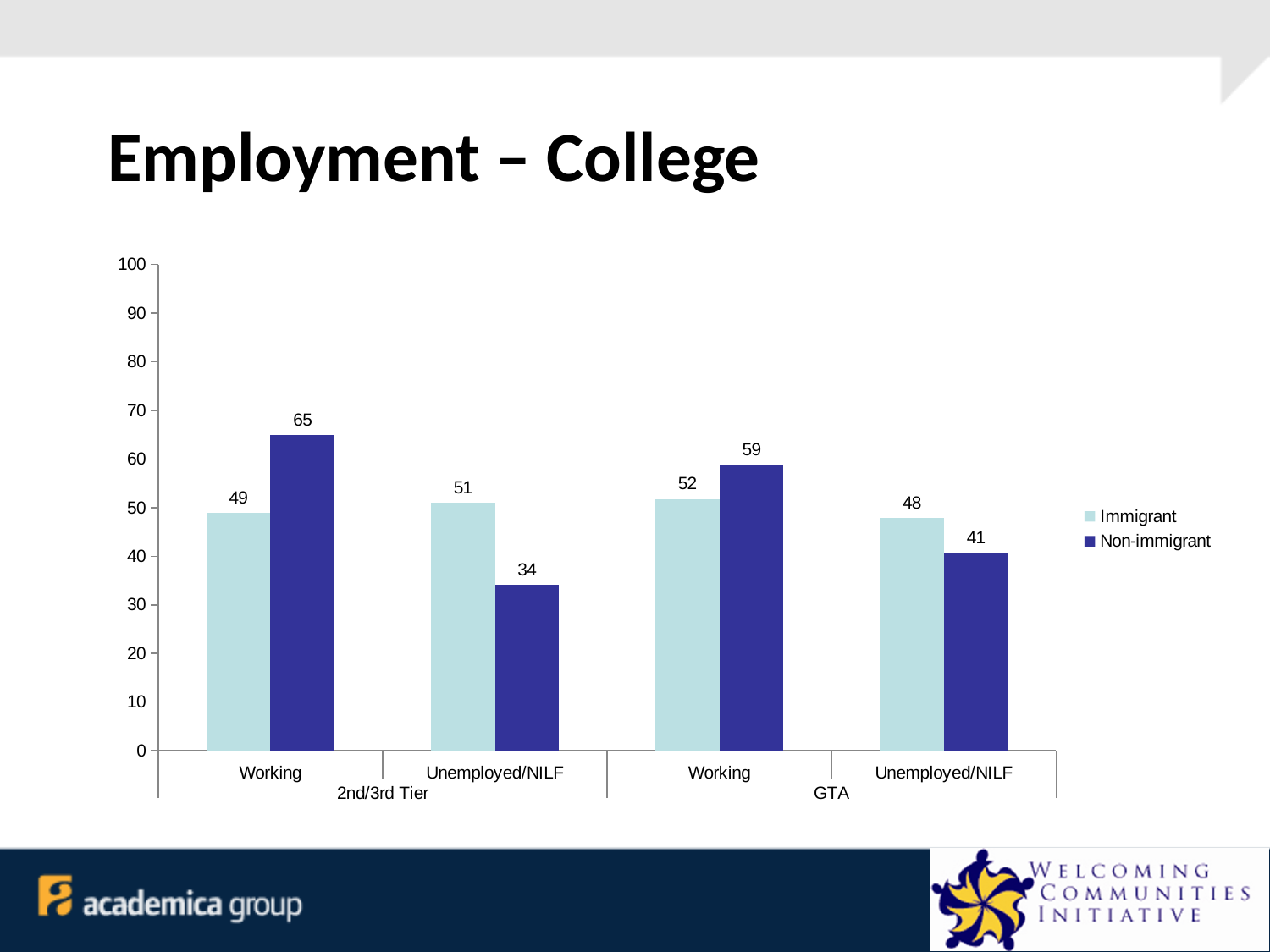
What is the Non-immigrant value for Unemployed/NILF in the 2nd/3rd Tier group? 34 Which category has the highest Non-immigrant value? Working (2nd/3rd Tier) Is the Non-immigrant value for Working in the GTA group greater or less than 50? greater What is the difference between the Immigrant and Non-immigrant values for Unemployed/NILF in the GTA group? 7 What is the difference between the Non-immigrant and Immigrant values for Working in the 2nd/3rd Tier group? 16 What is the Immigrant value for Unemployed/NILF in the GTA group? 48 What is the title of the slide? Employment – College What kind of chart is shown on the slide? Bar chart What is the Non-immigrant value for Working in the 2nd/3rd Tier group? 65 Which category has the lowest Non-immigrant value? Unemployed/NILF (2nd/3rd Tier) For Working in the GTA group, which is larger: the Immigrant value or the Non-immigrant value? Non-immigrant How many series does the legend list? 2